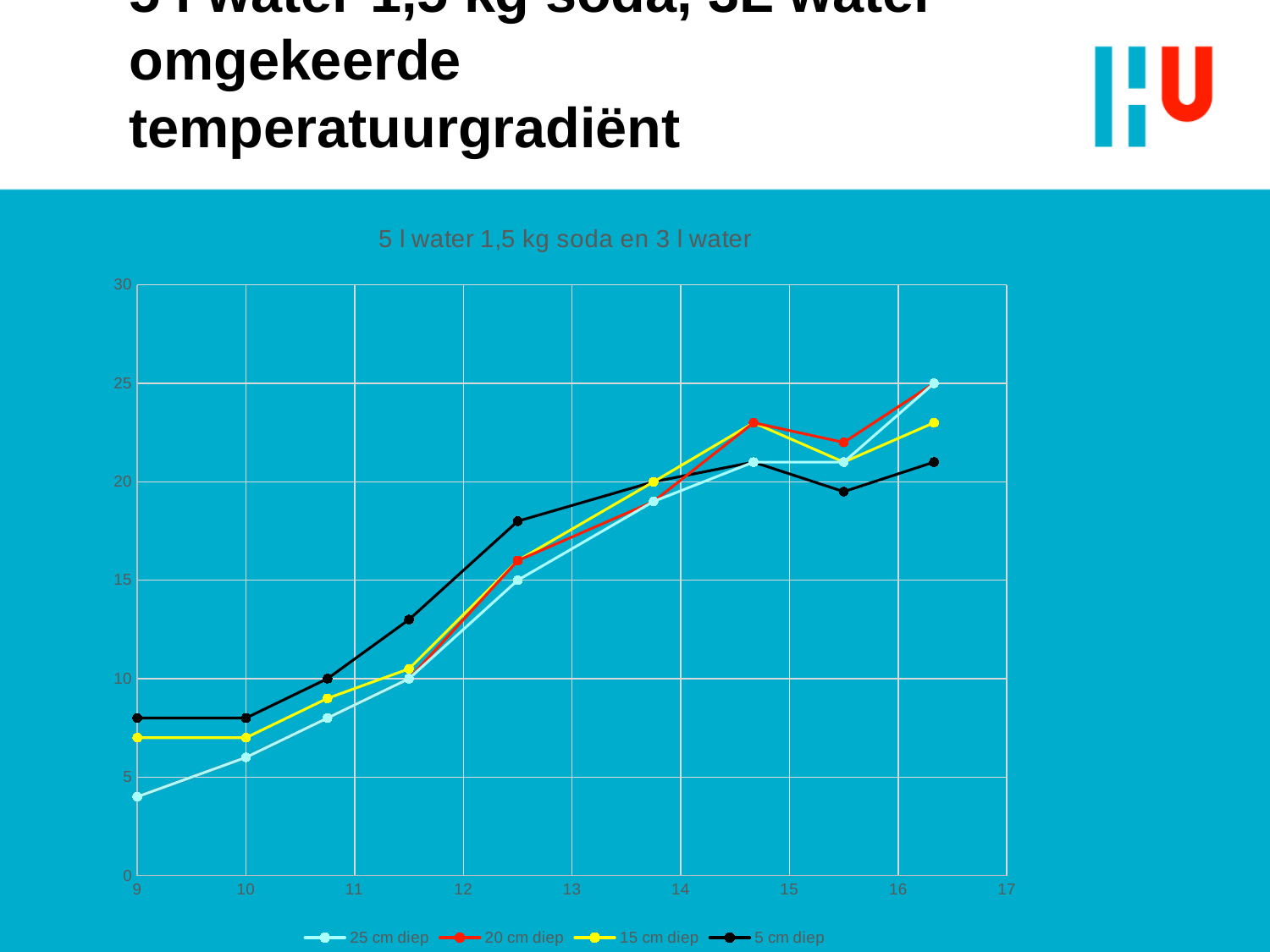
Is the value for 25 cm diep at x = 9 greater or less than 5? less Is the value for 5 cm diep at its last point (around x = 16.3) greater or less than 20? greater Do the values of the 25 cm diep series generally rise or fall along the x axis? rise Is the value for 15 cm diep at its last point (around x = 16.3) greater or less than 25? less What is the title of the chart? 5 l water 1,5 kg soda en 3 l water What kind of chart is shown on the slide? line chart How many series does the legend list? 4 At the last point (around x = 16.3), which series has the higher value: 25 cm diep or 5 cm diep? 25 cm diep At x = 9, which series has the higher value: 5 cm diep or 25 cm diep? 5 cm diep Which series is drawn in black? 5 cm diep